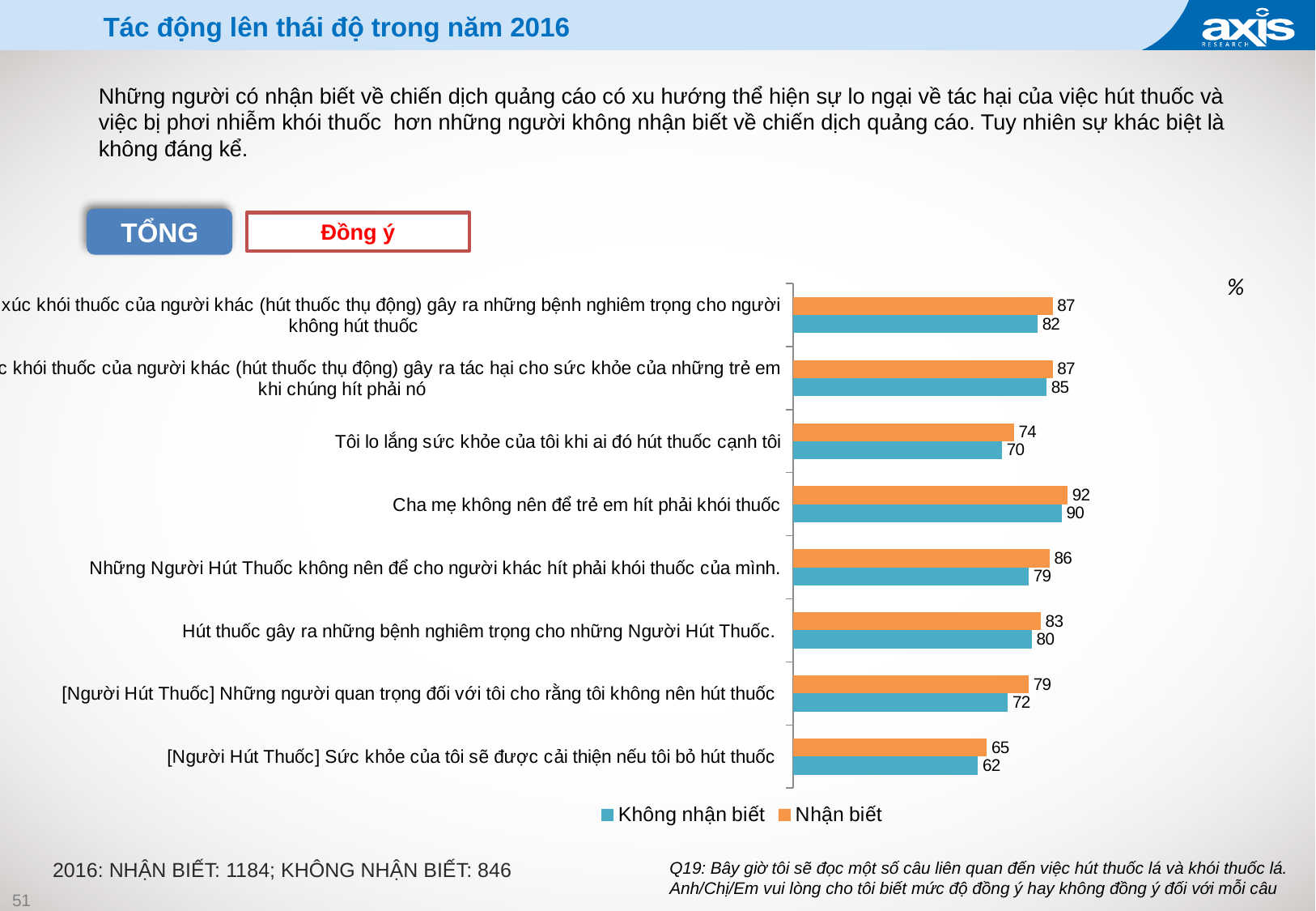
What is the difference between "Nhận biết" and "Không nhận biết" for the statement "Những Người Hút Thuốc không nên để cho người khác hít phải khói thuốc của mình."? 7 What is the value for "Không nhận biết" on the statement "Tôi lo lắng sức khỏe của tôi khi ai đó hút thuốc cạnh tôi"? 70 For the statement "[Người Hút Thuốc] Những người quan trọng đối với tôi cho rằng tôi không nên hút thuốc", which series has the larger value, "Nhận biết" or "Không nhận biết"? Nhận biết What is the value for "Nhận biết" on the statement "Hút thuốc gây ra những bệnh nghiêm trọng cho những Người Hút Thuốc."? 83 What type of chart is shown on the slide? bar chart What is the value for "Không nhận biết" on the statement "[Người Hút Thuốc] Sức khỏe của tôi sẽ được cải thiện nếu tôi bỏ hút thuốc"? 62 Which colour represents the "Nhận biết" series in the chart? orange How many series does the legend list? 2 Which statement has the lowest value for the "Không nhận biết" series? [Người Hút Thuốc] Sức khỏe của tôi sẽ được cải thiện nếu tôi bỏ hút thuốc How many statements (categories) are plotted in the chart? 8 What is the value for "Nhận biết" on the statement "Cha mẹ không nên để trẻ em hít phải khói thuốc"? 92 Which statement has the highest value for the "Nhận biết" series? Cha mẹ không nên để trẻ em hít phải khói thuốc